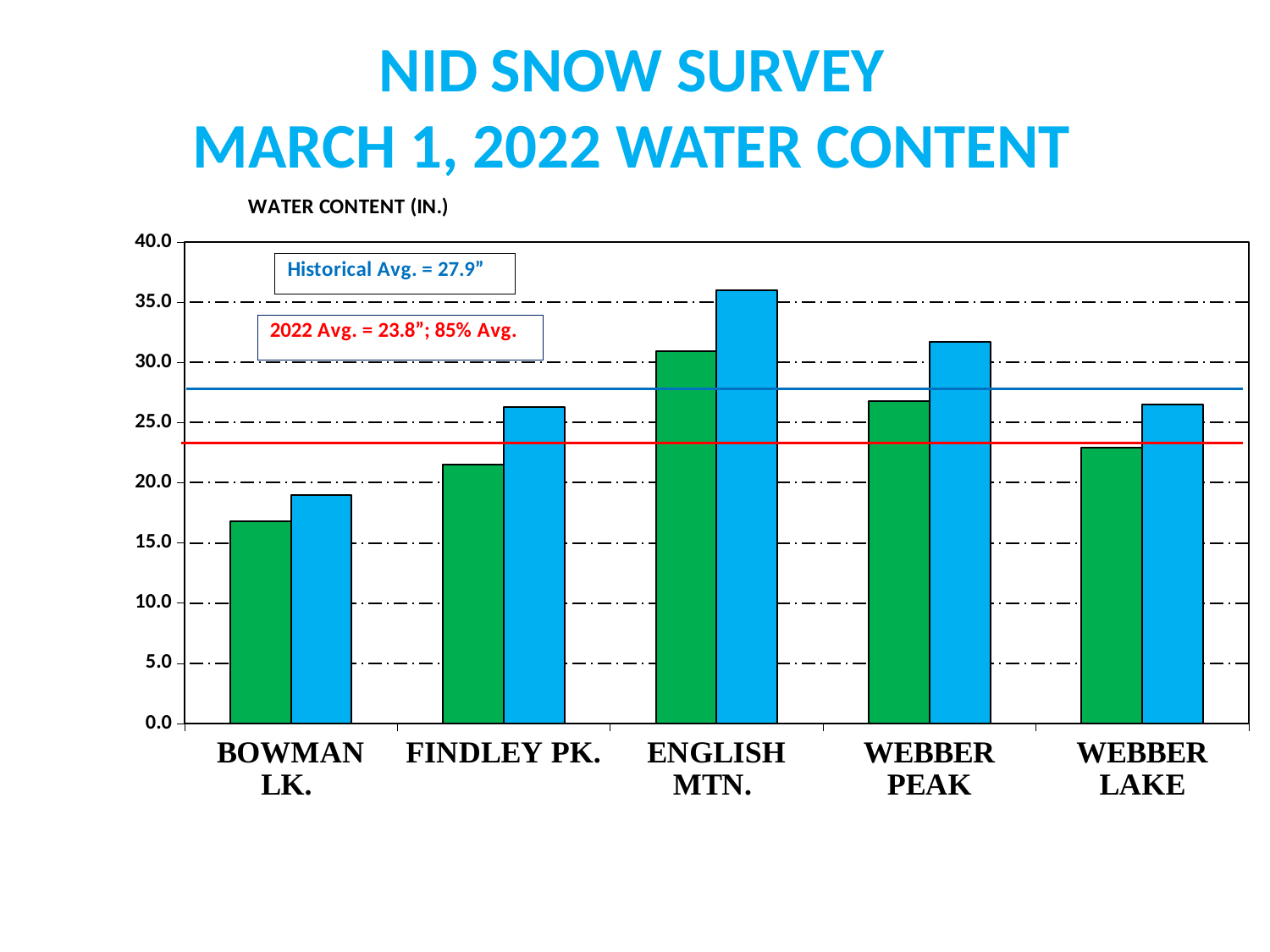
Which site has the tallest blue bar? ENGLISH MTN. Is the blue bar for BOWMAN LK. greater or less than 20.0? less Is the green bar for FINDLEY PK. greater or less than 25.0? less Is the blue bar for ENGLISH MTN. greater or less than 35.0? greater Which site has the shortest green bar? BOWMAN LK. What is the label of the vertical axis? WATER CONTENT (IN.) What kind of chart is shown on the slide? bar chart How many snow survey sites are shown along the x axis? 5 Which is taller, the blue bar for ENGLISH MTN. or the blue bar for WEBBER LAKE? ENGLISH MTN. Which is taller, the green bar for WEBBER PEAK or the green bar for FINDLEY PK.? WEBBER PEAK What historical average value is stated in the text box on the chart? 27.9"